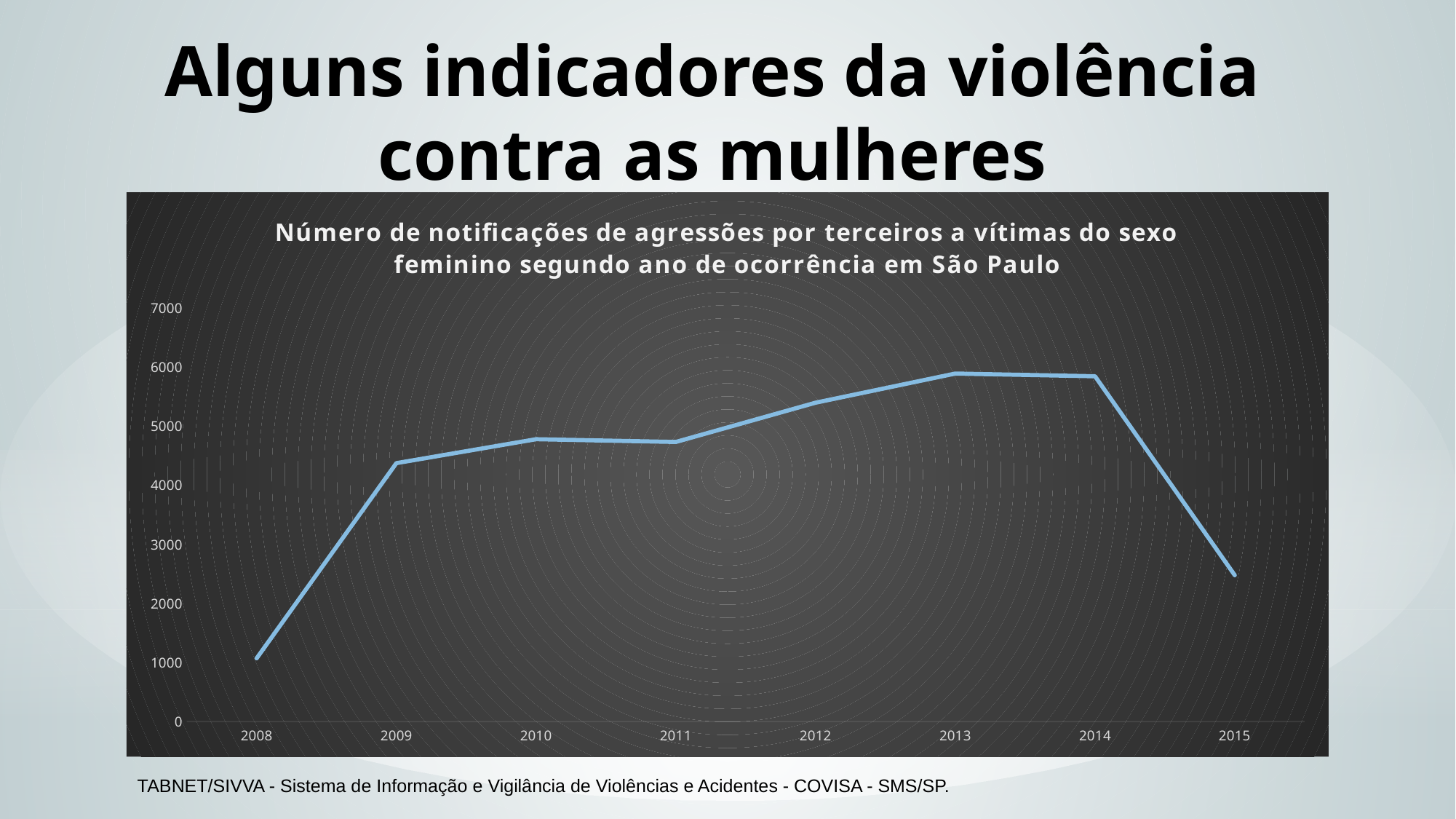
Which year has the lowest number of notifications in the chart? 2008 What is the title of the chart? Número de notificações de agressões por terceiros a vítimas do sexo feminino segundo ano de ocorrência em São Paulo Is the value for 2008 greater or less than 2000? less Is the value for 2009 greater or less than 4000? greater How many years are plotted on the x axis of the chart? 8 Is the value for 2012 greater or less than 5000? greater Does the line rise or fall between 2014 and 2015? fall Which year has the larger value, 2012 or 2011? 2012 Which year has the larger value, 2014 or 2015? 2014 What kind of chart is shown on the slide? line chart